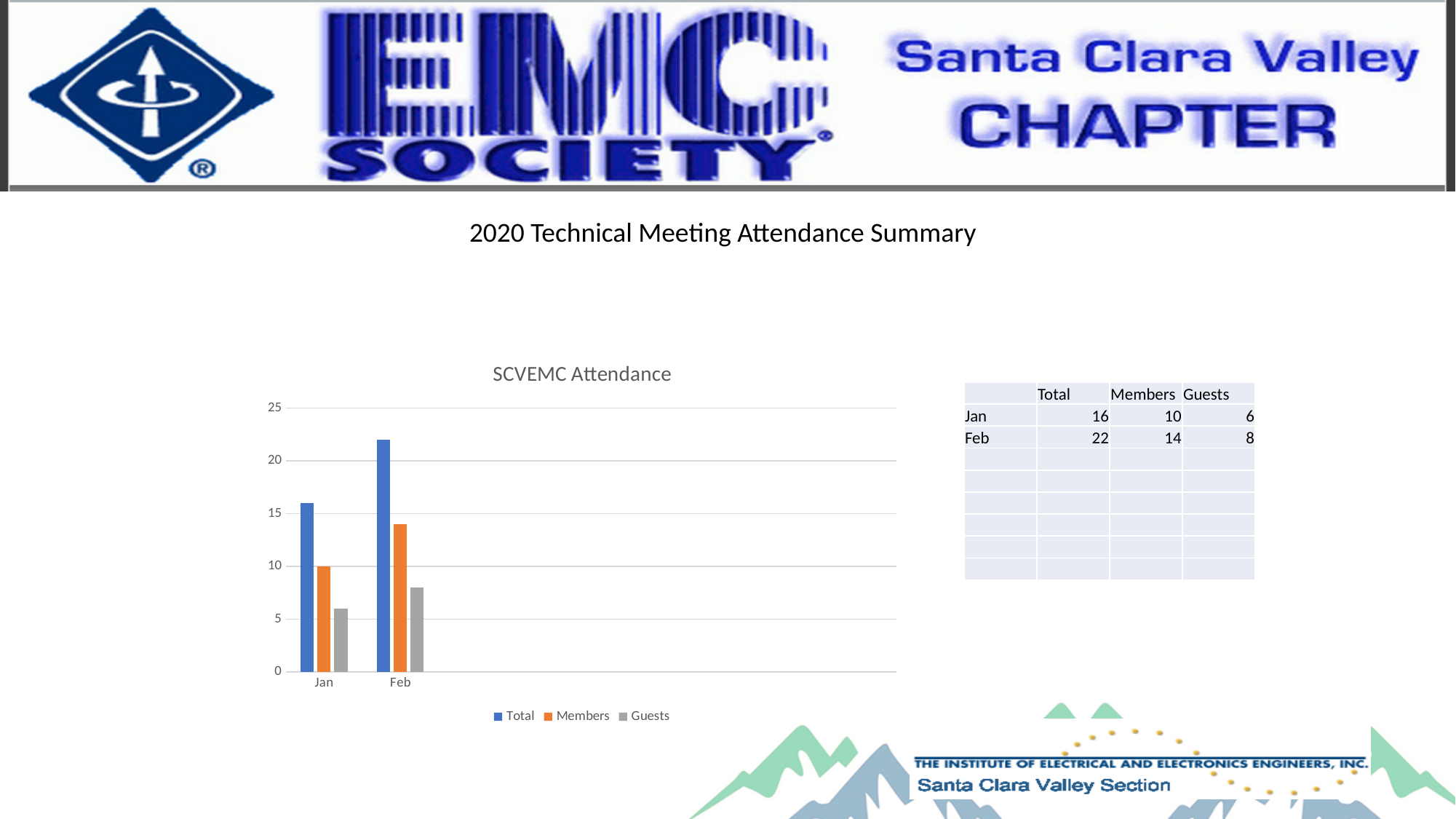
Is the Total value for Feb greater or less than 20 in the SCVEMC Attendance chart? greater Which month has the higher Total attendance in the SCVEMC Attendance chart? Feb Which series has the lowest value for Jan in the SCVEMC Attendance chart? Guests What type of chart is the SCVEMC Attendance chart? bar chart How many categories are shown on the x axis of the SCVEMC Attendance chart? 2 How many series does the legend of the SCVEMC Attendance chart list? 3 What is the Total attendance value for Feb in the SCVEMC Attendance chart? 22 What is the Guests value for Feb in the SCVEMC Attendance chart? 8 Does the Guests series rise or fall from Jan to Feb in the SCVEMC Attendance chart? rise Is the Members value for Feb greater or less than the Members value for Jan in the SCVEMC Attendance chart? greater What is the difference between the Total attendance for Feb and Jan in the SCVEMC Attendance chart? 6 What is the Members value for Jan in the SCVEMC Attendance chart? 10